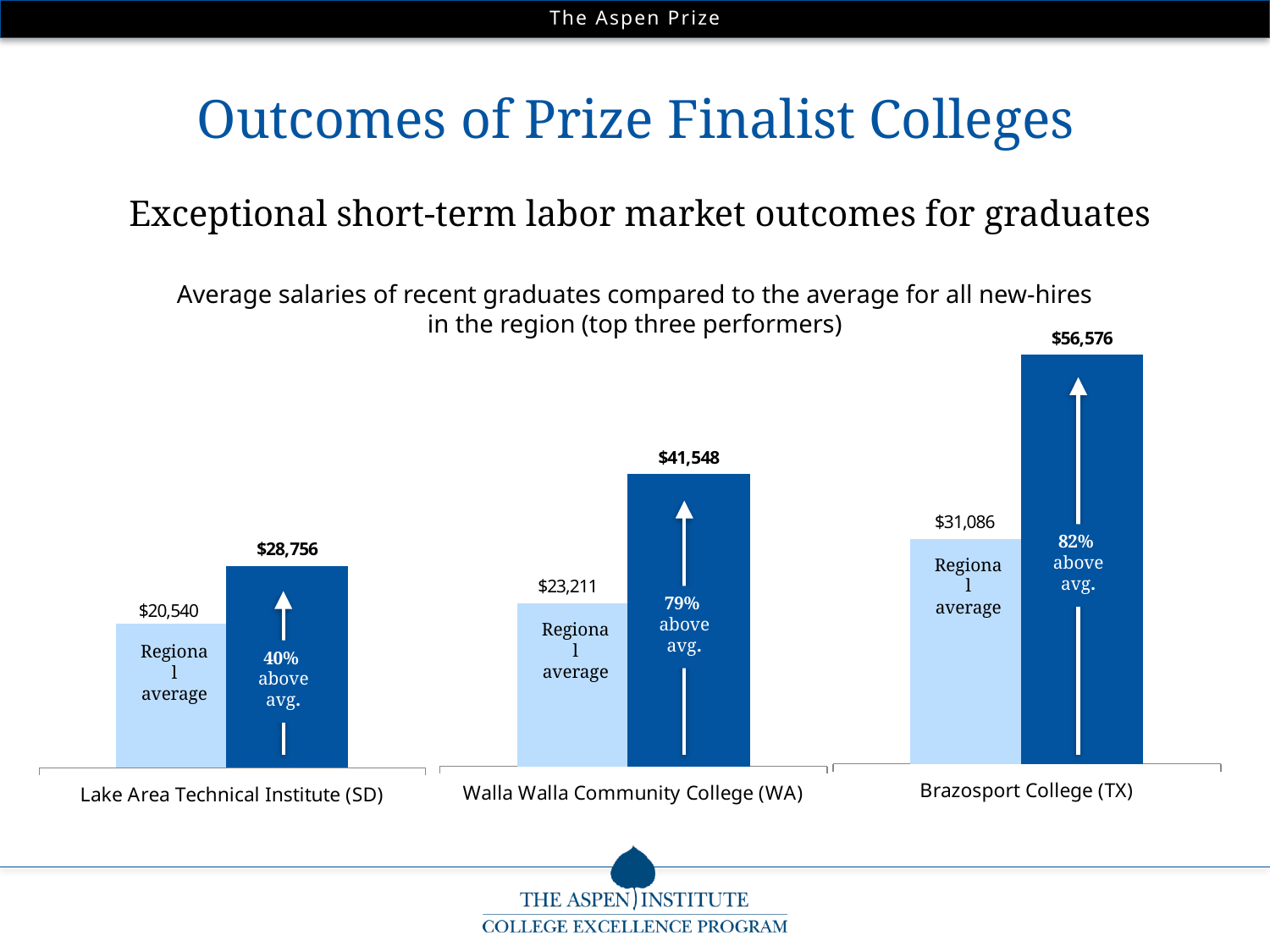
Across the three charts, which college has the lowest regional average salary? Lake Area Technical Institute (SD) In the Lake Area Technical Institute (SD) chart, what is the average salary of recent graduates? $28,756 In the Lake Area Technical Institute (SD) chart, what is the regional average salary? $20,540 In the Brazosport College (TX) chart, what is the regional average salary? $31,086 In the Lake Area Technical Institute (SD) chart, what is the difference between the graduate salary and the regional average? $8,216 In the Brazosport College (TX) chart, what is the average salary of recent graduates? $56,576 Across the three charts, which college has the highest average salary for recent graduates? Brazosport College (TX) In the Walla Walla Community College (WA) chart, what is the average salary of recent graduates? $41,548 What kind of chart is used for each college on the slide? Bar chart In the Walla Walla Community College (WA) chart, what is the regional average salary? $23,211 In the Walla Walla Community College (WA) chart, what is the difference between the graduate salary and the regional average? $18,337 In the Brazosport College (TX) chart, by what percentage are graduate salaries above the regional average? 82%